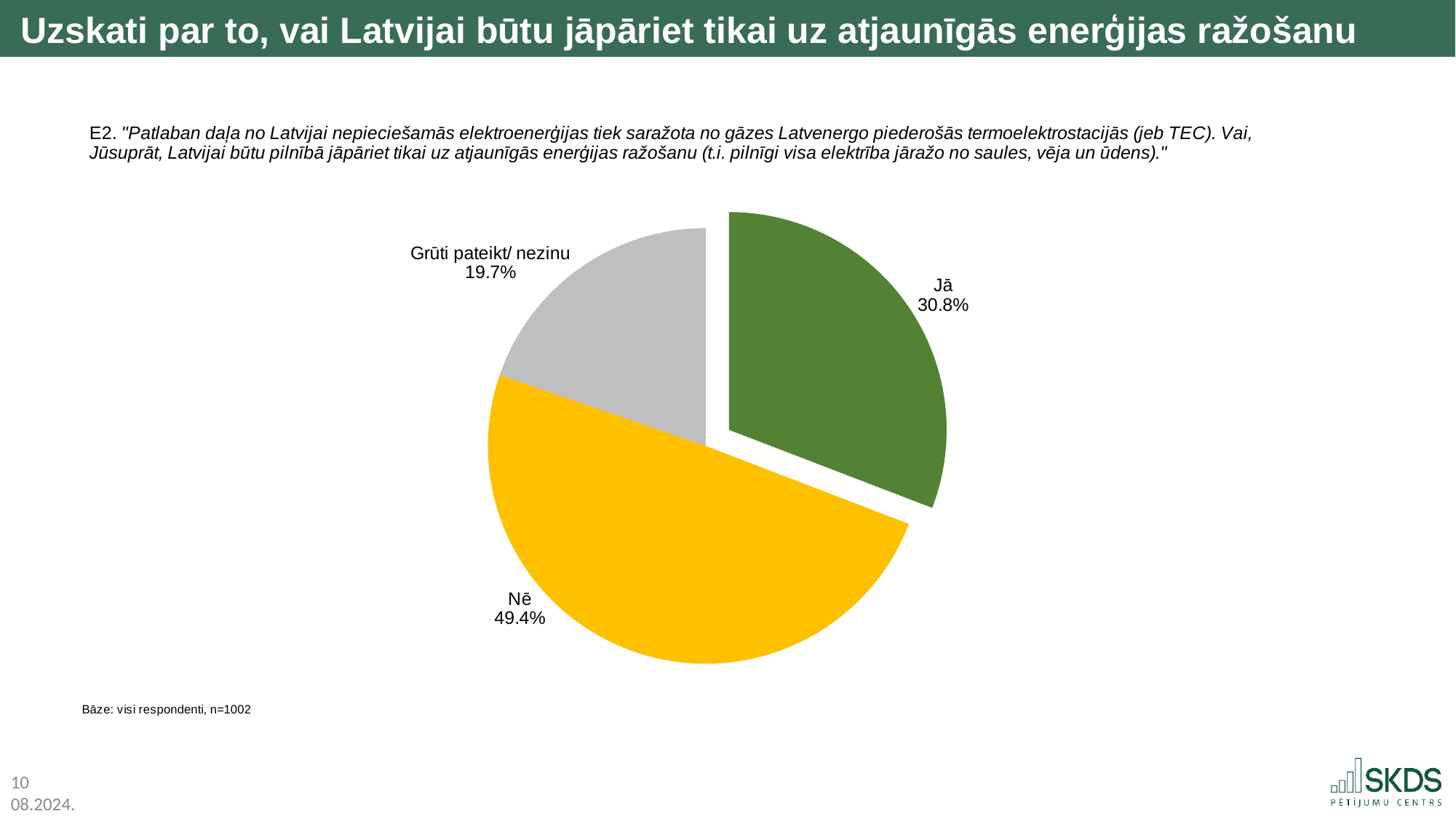
What colour is the "Jā" slice? Green Which slice is pulled out (exploded) from the rest of the pie? Jā What percentage of respondents answered "Jā"? 30.8% What type of chart is shown on the slide? Pie chart Which is larger, the share for "Jā" or the share for "Grūti pateikt/ nezinu"? Jā Which response has the largest share of the pie? Nē What is the difference in percentage points between "Nē" and "Jā"? 18.6 What percentage of respondents answered "Nē"? 49.4% How many slices does the pie chart have? 3 What percentage of respondents answered "Grūti pateikt/ nezinu"? 19.7% What is the difference in percentage points between "Jā" and "Grūti pateikt/ nezinu"? 11.1 Which response has the smallest share of the pie? Grūti pateikt/ nezinu